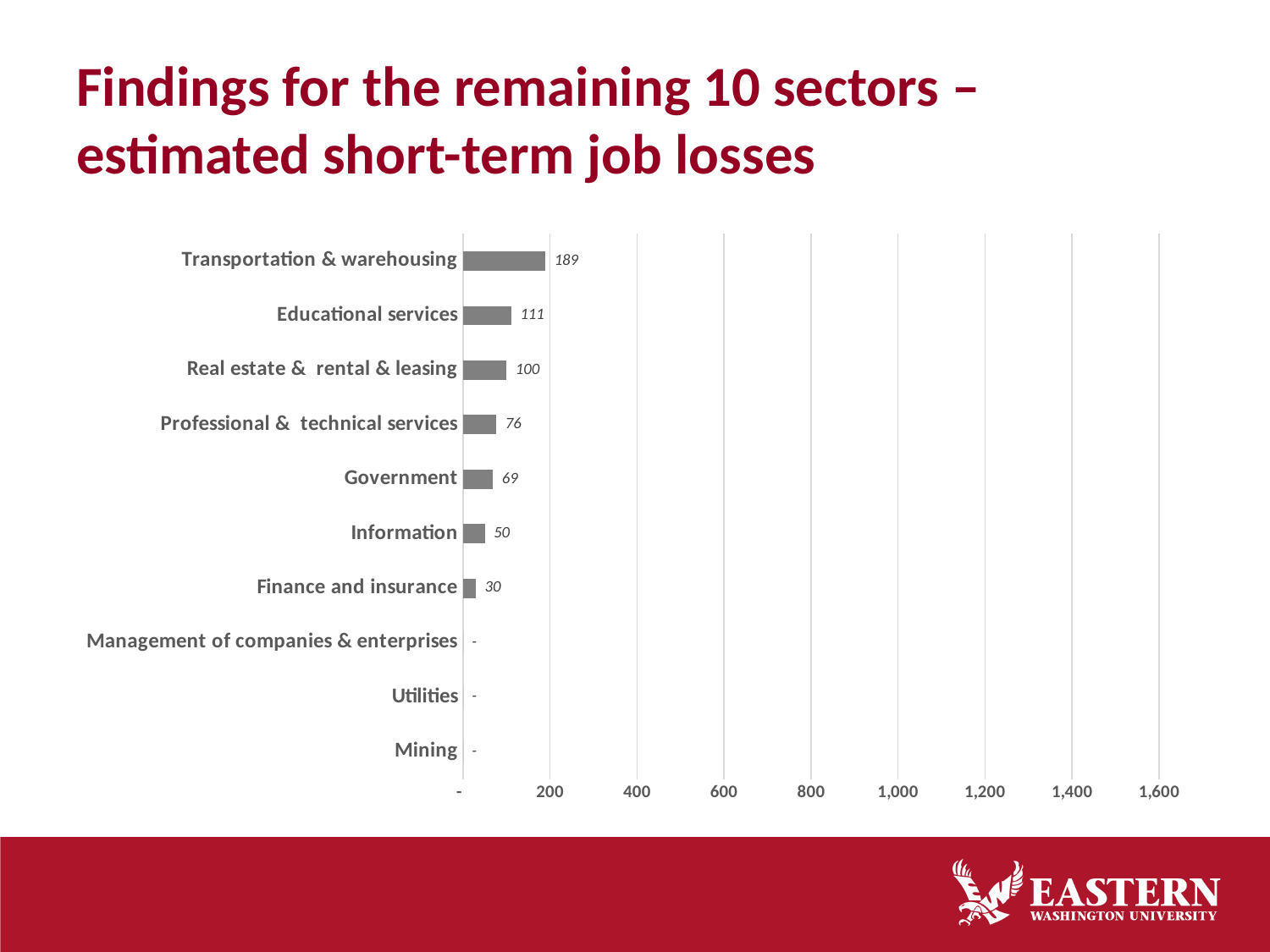
What is the difference between the values for Transportation & warehousing and Educational services? 78 What is the estimated short-term job loss for Transportation & warehousing? 189 Is the value for Transportation & warehousing greater or less than 200? less What is the highest value labelled on the horizontal axis? 1,600 What is the value shown for Finance and insurance? 30 What is the value shown for Government? 69 Which is larger, the value for Professional & technical services or the value for Government? Professional & technical services How many sectors are listed on the chart? 10 What is the difference between the values for Real estate & rental & leasing and Information? 50 What kind of chart is shown on the slide? bar chart Which sector has the highest estimated short-term job losses? Transportation & warehousing What is the value shown for Educational services? 111